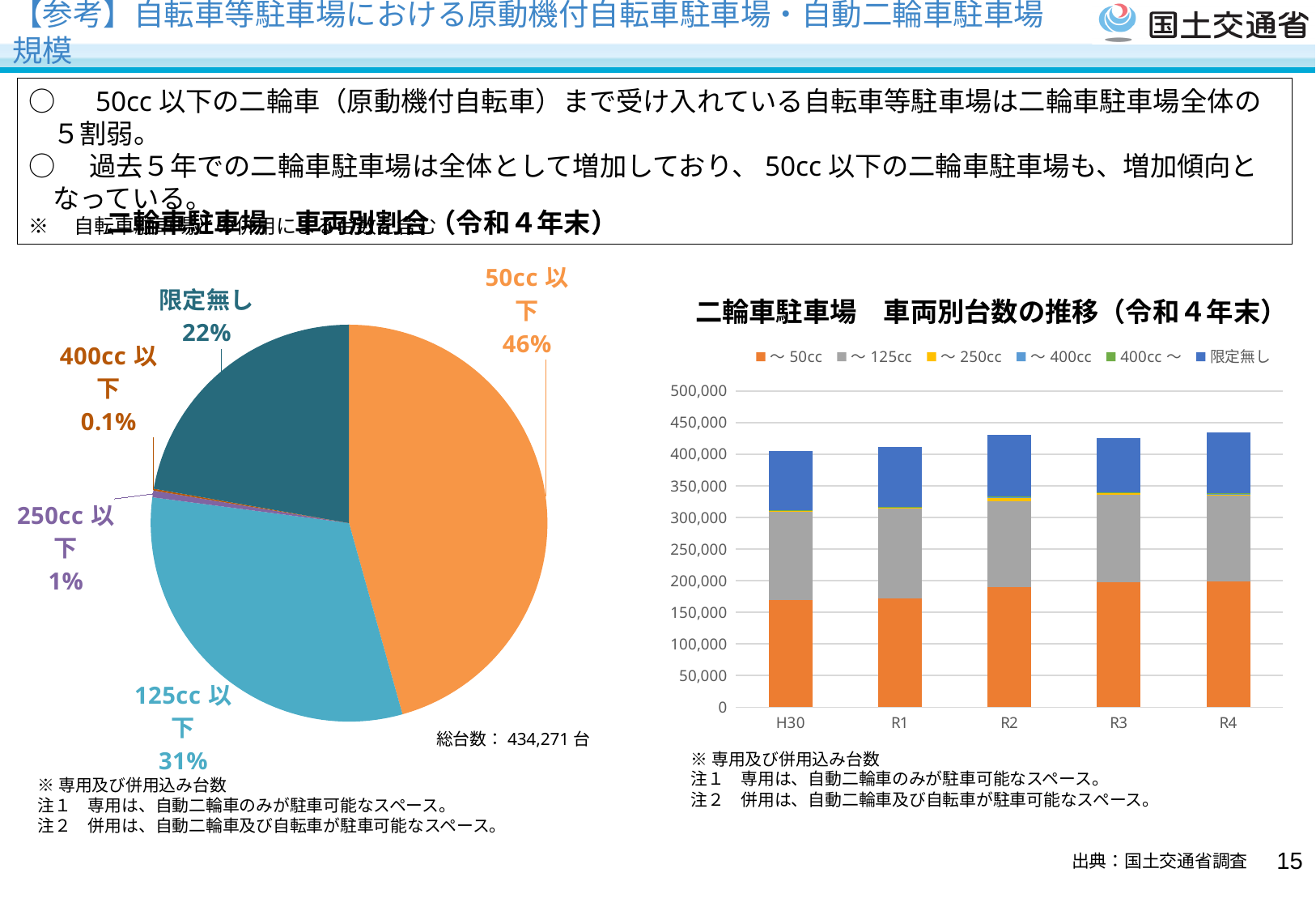
In the chart 二輪車駐車場 車両別台数の推移（令和４年末）, is the total stacked bar for R2 greater or less than 400,000? greater In the pie chart 二輪車駐車場 車両別割合（令和４年末）, what is the total number of spaces (総台数) shown? 434,271台 In the pie chart 二輪車駐車場 車両別割合（令和４年末）, which is larger, 125cc以下 or 限定無し? 125cc以下 In the pie chart 二輪車駐車場 車両別割合（令和４年末）, what share is shown for 50cc以下? 46% How many slices does the pie chart 二輪車駐車場 車両別割合（令和４年末） have? 5 What kind of chart is 二輪車駐車場 車両別台数の推移（令和４年末）? Stacked bar chart In the pie chart 二輪車駐車場 車両別割合（令和４年末）, what is the difference in percentage points between 50cc以下 and 125cc以下? 15% How many series does the legend of the chart 二輪車駐車場 車両別台数の推移（令和４年末）list? 6 In the chart 二輪車駐車場 車両別台数の推移（令和４年末）, is the ～50cc value for H30 greater or less than 200,000? less In the pie chart 二輪車駐車場 車両別割合（令和４年末）, what share is shown for 限定無し? 22% In the pie chart 二輪車駐車場 車両別割合（令和４年末）, which category has the largest share? 50cc以下 In the pie chart 二輪車駐車場 車両別割合（令和４年末）, which category has the smallest share? 400cc以下